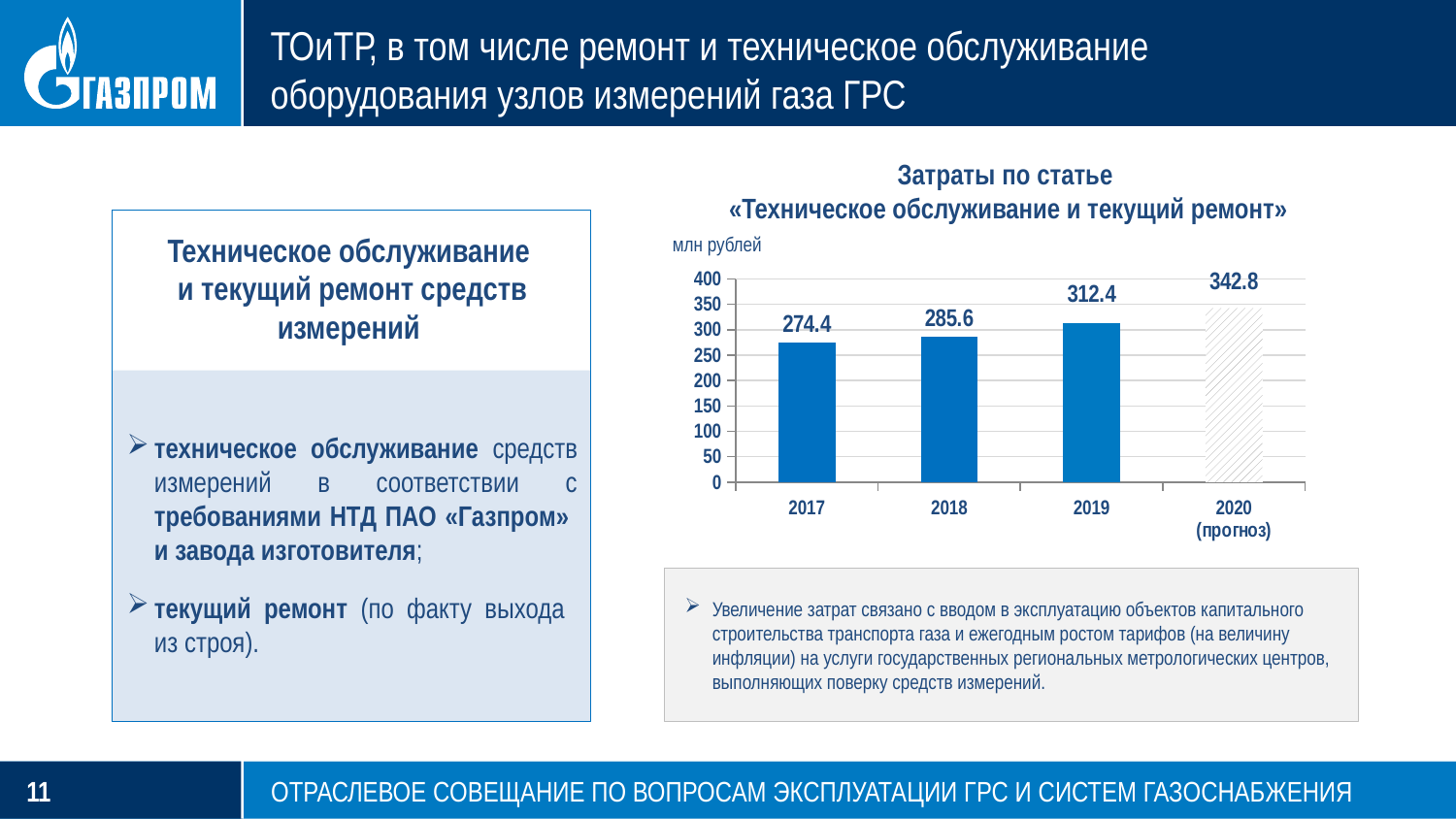
Which year has the highest value? 2020 (прогноз) How many years are shown on the x axis? 4 Which year has the lowest value? 2017 What unit is stated above the chart? млн рублей What is the difference between the values for 2019 and 2018? 26.8 What is the value for 2020 (прогноз)? 342.8 What kind of chart is shown? bar chart What is the value for 2017? 274.4 What is the value for 2019? 312.4 Do the values rise or fall from 2017 to 2020? rise Is the value for 2019 greater or less than 300? greater Which is larger, the value for 2018 or the value for 2017? 2018